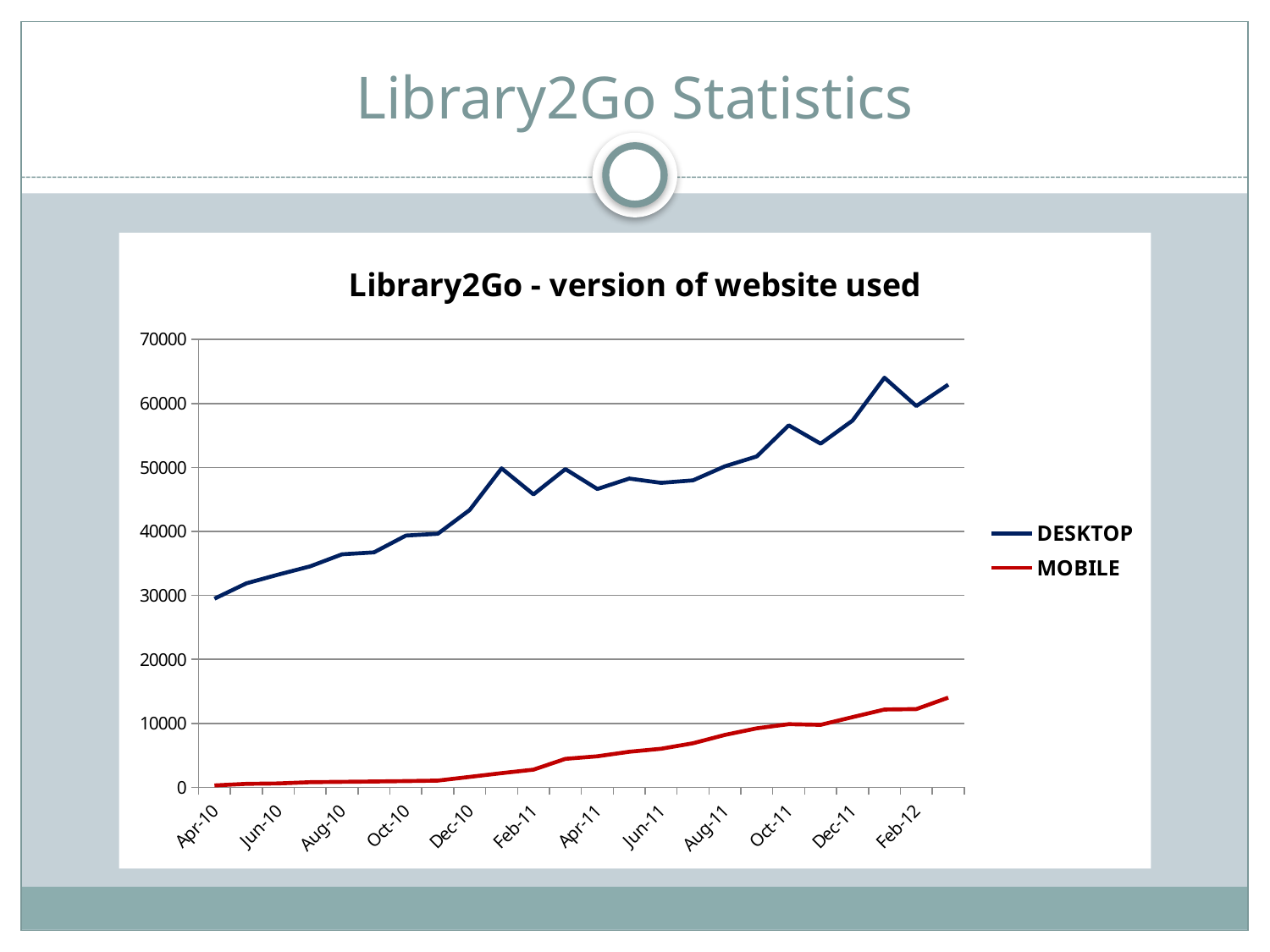
Is the DESKTOP value for Oct-11 greater or less than 50000? greater Is the DESKTOP value for Feb-11 greater or less than 40000? greater How many series does the legend list? 2 Is the MOBILE value for Apr-11 greater or less than 10000? less What is the title of the chart? Library2Go - version of website used Does the MOBILE series generally rise or fall from Apr-10 to Feb-12? rise Which series has the higher values throughout the chart, DESKTOP or MOBILE? DESKTOP Which series is drawn in red? MOBILE What kind of chart is shown on the slide? line chart At which labelled month is the DESKTOP value lowest? Apr-10